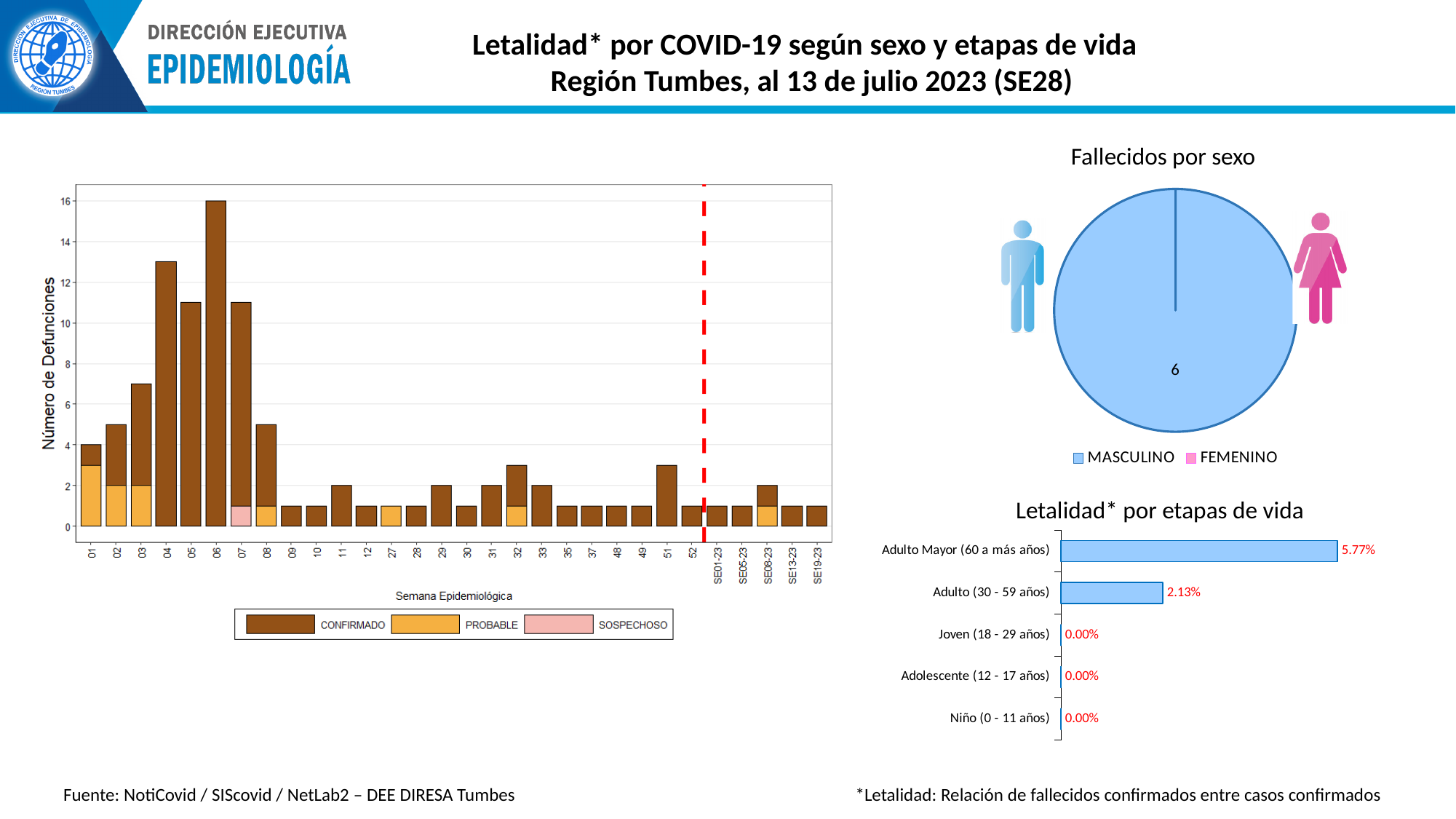
In the 'Letalidad* por etapas de vida' chart, what is the value for Adulto (30 - 59 años)? 2.13% In the 'Letalidad* por etapas de vida' chart, what is the difference between the values for Adulto Mayor (60 a más años) and Adulto (30 - 59 años)? 3.64% In the 'Fallecidos por sexo' pie chart, what value is shown for MASCULINO? 6 In the bar chart on the left (Número de Defunciones by Semana Epidemiológica), how many series does the legend list? 3 In the 'Letalidad* por etapas de vida' chart, how many age groups are shown? 5 In the 'Letalidad* por etapas de vida' chart, what is the value for Adulto Mayor (60 a más años)? 5.77% In the 'Letalidad* por etapas de vida' chart, what is the value for Joven (18 - 29 años)? 0.00% In the 'Fallecidos por sexo' pie chart, how many entries does the legend list? 2 In the 'Letalidad* por etapas de vida' chart, which age group has the highest letalidad? Adulto Mayor (60 a más años) In the bar chart on the left (Número de Defunciones by Semana Epidemiológica), is the total value for week 04 greater or less than 12? greater What kind of chart is the 'Letalidad* por etapas de vida' chart? Bar chart In the bar chart on the left (Número de Defunciones by Semana Epidemiológica), which epidemiological week has the highest number of deaths? 06